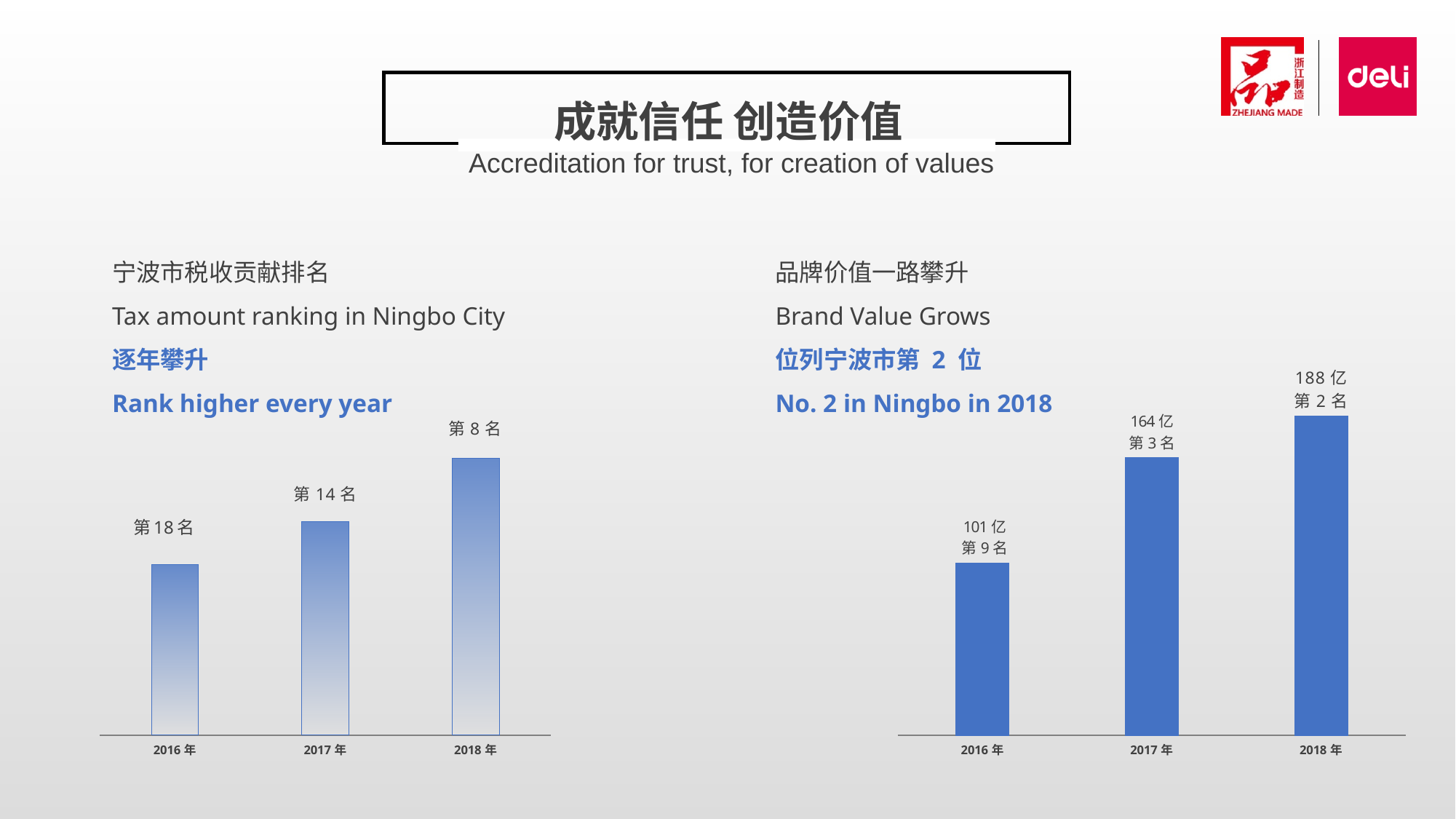
In the right chart (Brand Value Grows), what brand value is shown for 2017 年? 164 亿 In the left chart (Tax amount ranking in Ningbo City), how many bars are plotted? 3 In the left chart (Tax amount ranking in Ningbo City), what is the data label for 2018 年? 第 8 名 In the right chart (Brand Value Grows), which is larger, the brand value for 2017 年 or for 2016 年? 2017 年 In the right chart (Brand Value Grows), what brand value is shown for 2016 年? 101 亿 In the right chart (Brand Value Grows), what is the difference in brand value between 2018 年 and 2016 年? 87 亿 In the right chart (Brand Value Grows), what ranking is shown for 2018 年? 第 2 名 In the left chart (Tax amount ranking in Ningbo City), do the bars rise or fall from 2016 年 to 2018 年? rise What kind of chart is the right chart (Brand Value Grows)? bar chart In the right chart (Brand Value Grows), which year has the lowest brand value? 2016 年 In the left chart (Tax amount ranking in Ningbo City), what is the data label for 2016 年? 第 18 名 In the right chart (Brand Value Grows), which year has the highest brand value? 2018 年